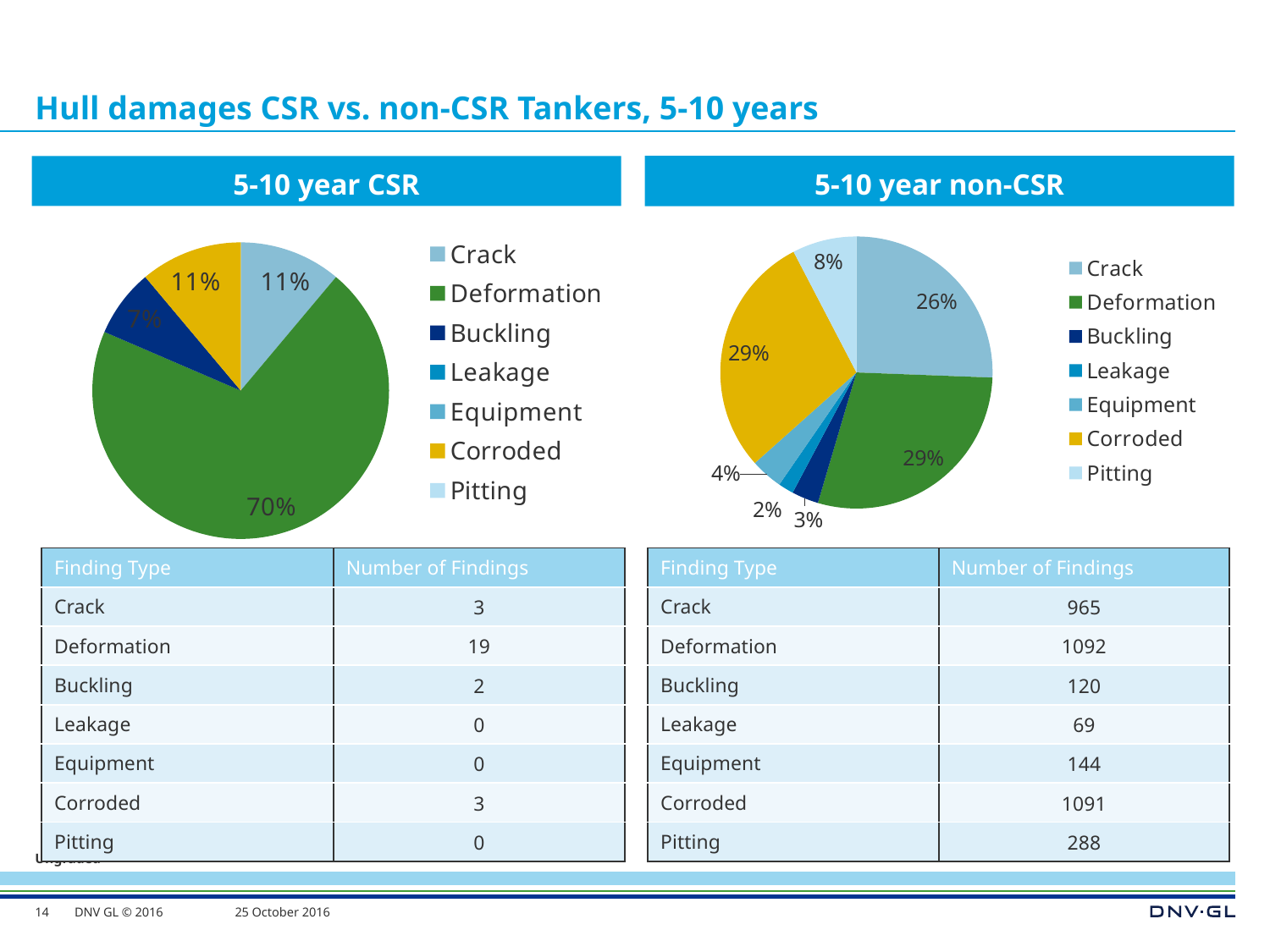
In the 5-10 year non-CSR pie chart, which finding type has the smallest slice? Leakage In the 5-10 year non-CSR pie chart, what share does Crack have? 26% What type of chart is used for the 5-10 year non-CSR data? Pie chart In the 5-10 year non-CSR pie chart, what share does Leakage have? 2% In the 5-10 year CSR pie chart, what share does Deformation have? 70% In the 5-10 year non-CSR pie chart, what is the difference in percentage points between the Deformation slice and the Crack slice? 3 In the 5-10 year non-CSR pie chart, which is larger, the Crack slice or the Corroded slice? Corroded In the 5-10 year CSR pie chart, what colour is the Corroded slice? Yellow In the 5-10 year CSR pie chart, which finding type has the largest slice? Deformation How many entries does the legend of the 5-10 year CSR chart list? 7